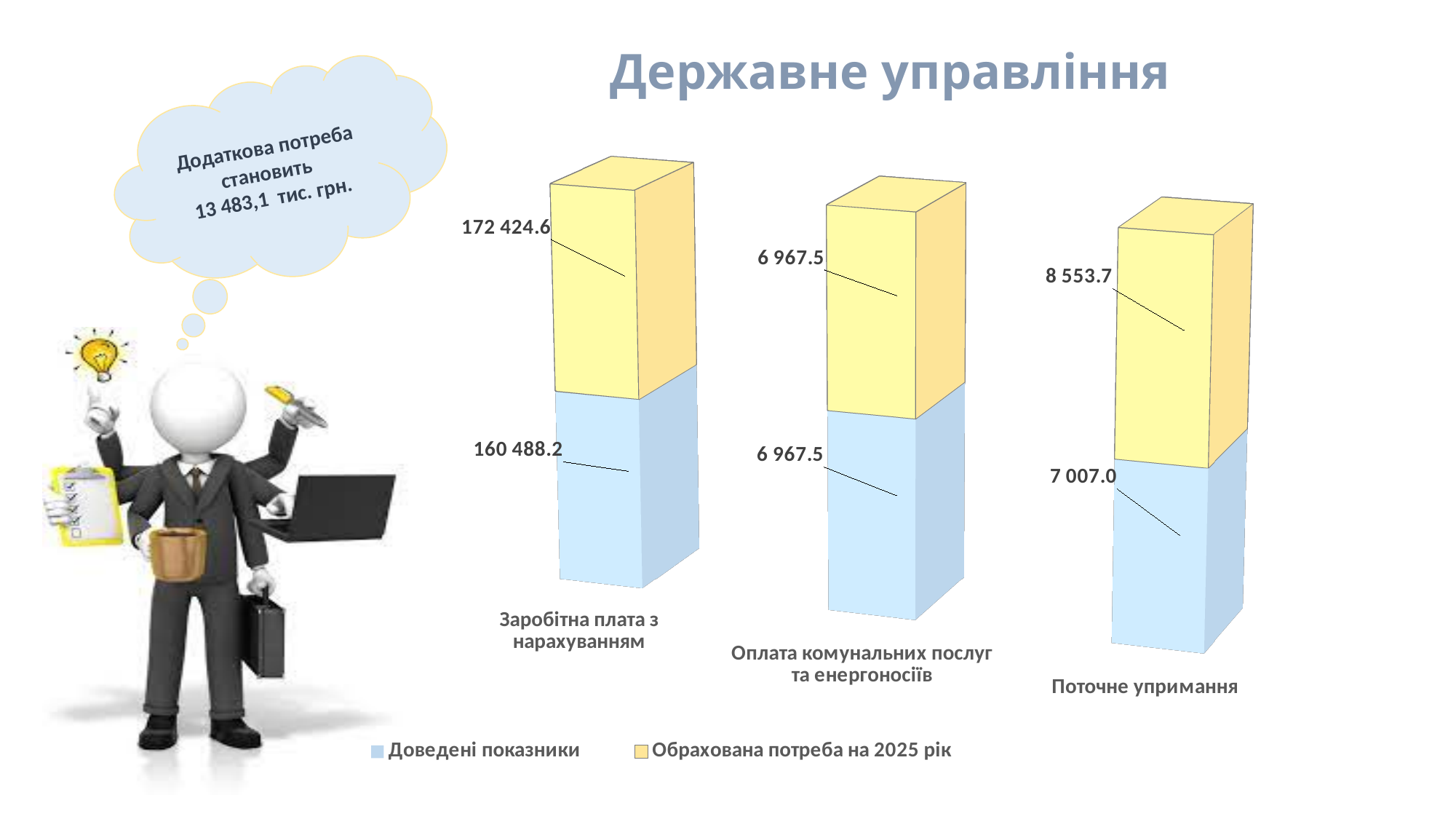
Which category has the lowest value for "Доведені показники"? Оплата комунальних послуг та енергоносіїв What is the difference between "Обрахована потреба на 2025 рік" and "Доведені показники" for "Поточне упримання"? 1 546.7 How many categories are shown on the chart? 3 How many series does the legend list? 2 What is the value of "Обрахована потреба на 2025 рік" for "Поточне упримання"? 8 553.7 What is the value of "Доведені показники" for "Поточне упримання"? 7 007.0 What is the value of "Доведені показники" for "Оплата комунальних послуг та енергоносіїв"? 6 967.5 What is the value of "Доведені показники" for "Заробітна плата з нарахуванням"? 160 488.2 Which category has the highest value for "Обрахована потреба на 2025 рік"? Заробітна плата з нарахуванням What is the value of "Обрахована потреба на 2025 рік" for "Заробітна плата з нарахуванням"? 172 424.6 What is the difference between "Обрахована потреба на 2025 рік" and "Доведені показники" for "Заробітна плата з нарахуванням"? 11 936.4 Which is larger: "Доведені показники" for "Поточне упримання" or for "Оплата комунальних послуг та енергоносіїв"? Поточне упримання